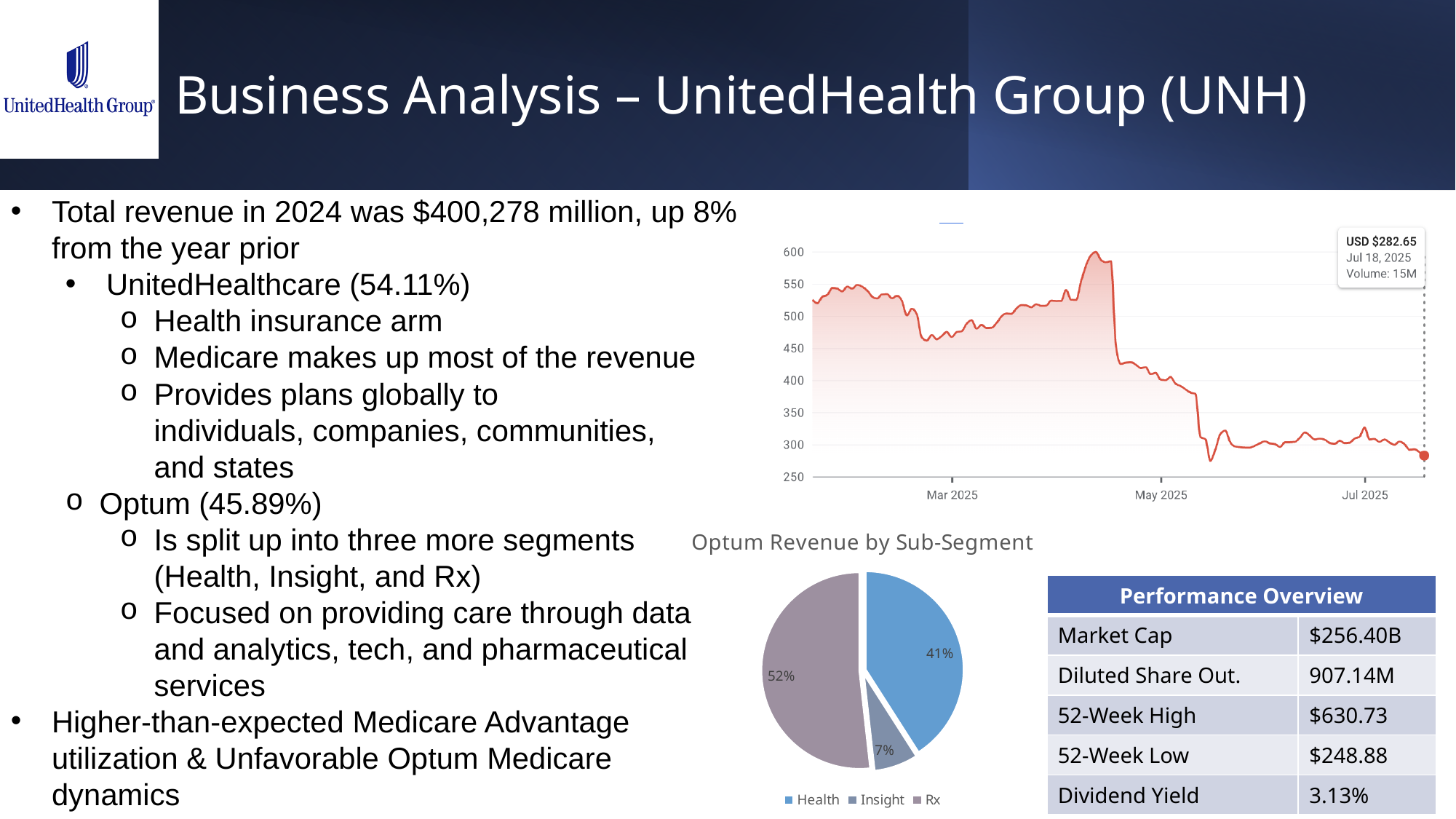
In the Optum Revenue by Sub-Segment pie chart, what share does Insight have? 7% In the Optum Revenue by Sub-Segment pie chart, which sub-segment has the smallest share? Insight What kind of chart is the stock price chart in the top right of the slide? line chart In the Optum Revenue by Sub-Segment pie chart, which sub-segment has the largest share? Rx In the stock price chart in the top right, what price is shown in the data label for Jul 18, 2025? USD $282.65 In the Optum Revenue by Sub-Segment pie chart, how many sub-segments does the legend list? 3 What kind of chart is the Optum Revenue by Sub-Segment chart? pie chart In the Optum Revenue by Sub-Segment pie chart, what share does Rx have? 52% In the Optum Revenue by Sub-Segment pie chart, what share does Health have? 41% In the stock price chart in the top right, does the price overall rise or fall from the start of the chart to Jul 2025? fall In the Optum Revenue by Sub-Segment pie chart, how many percentage points larger is Rx's share than Health's share? 11